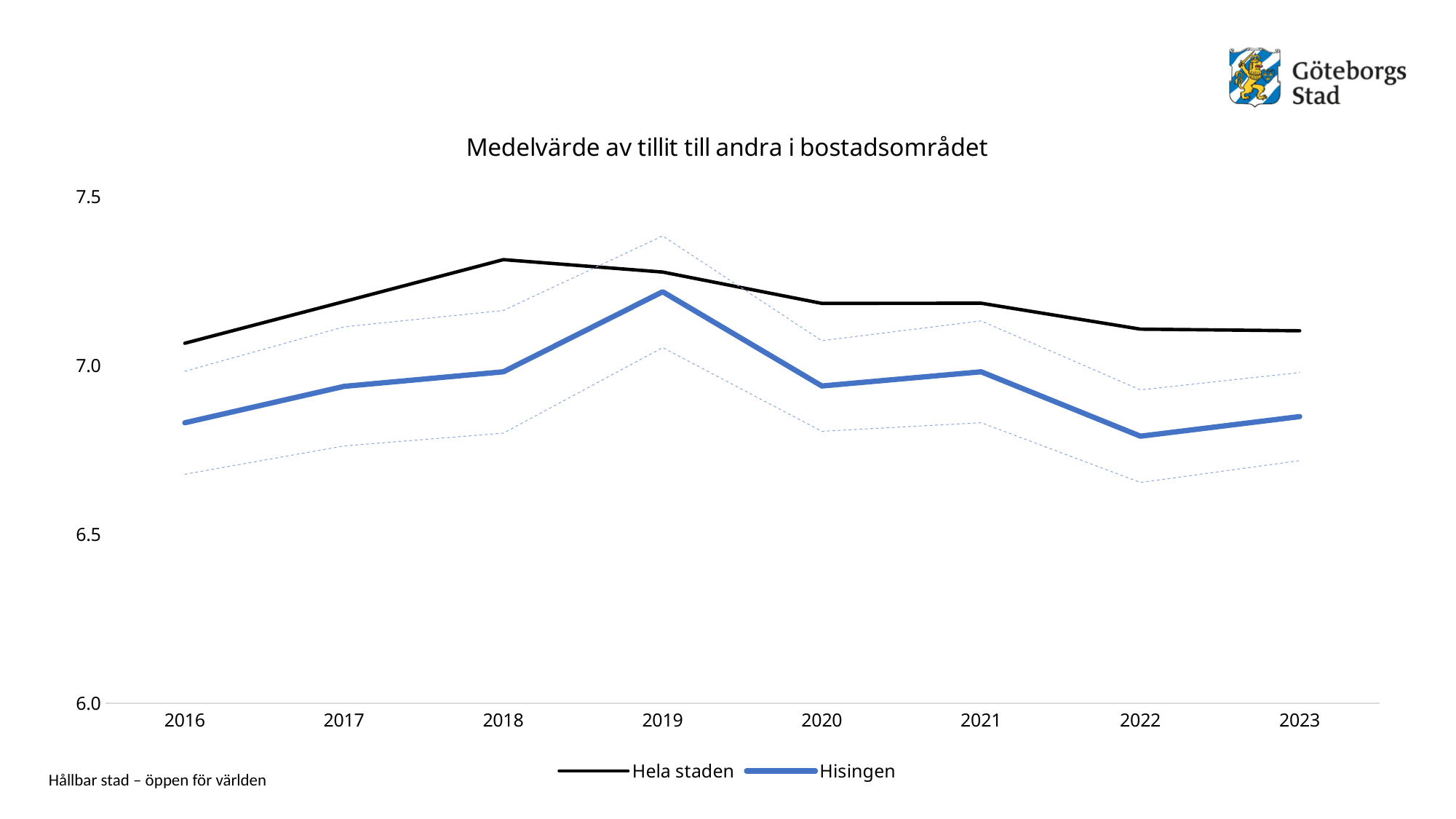
Is the value for Hisingen in 2022 greater or less than 7.0? less Which series has the higher value in 2020, Hela staden or Hisingen? Hela staden What kind of chart is shown on the slide? Line chart How many series does the legend list? 2 Which series is drawn with the blue line? Hisingen Is the value for Hisingen in 2019 greater or less than 7.0? greater Which is larger for Hisingen, the value in 2019 or the value in 2020? 2019 Is the value for Hela staden in 2018 greater or less than 7.0? greater Does the Hela staden series rise or fall from 2018 to 2023? Fall How many years are shown on the x axis? 8 In which year does the Hisingen series reach its highest value? 2019 What is the title of the chart? Medelvärde av tillit till andra i bostadsområdet